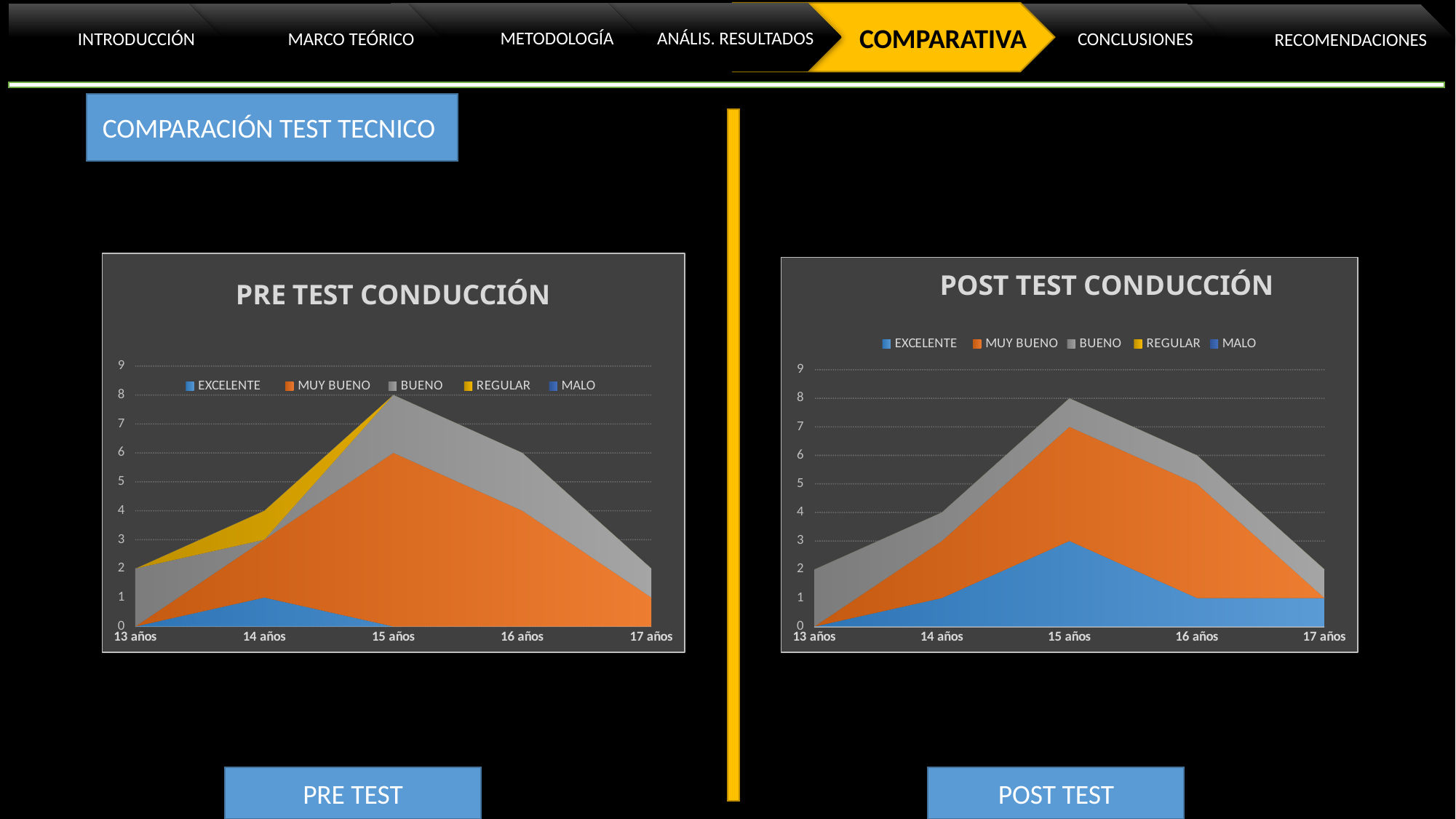
How many series does the legend of the PRE TEST CONDUCCIÓN chart list? 5 In the POST TEST CONDUCCIÓN chart, is the value for EXCELENTE at 15 años greater or less than 2? greater In the PRE TEST CONDUCCIÓN chart, at which age category does the plotted area reach its highest point? 15 años In the PRE TEST CONDUCCIÓN chart, do the plotted values rise or fall from 15 años to 17 años? fall What kind of chart is the PRE TEST CONDUCCIÓN chart? area chart Which series are listed in the legend of the POST TEST CONDUCCIÓN chart? EXCELENTE, MUY BUENO, BUENO, REGULAR, MALO What kind of chart is the POST TEST CONDUCCIÓN chart? area chart How many age categories are shown on the x axis of the PRE TEST CONDUCCIÓN chart? 5 In the POST TEST CONDUCCIÓN chart, is the value for EXCELENTE at 13 años greater or less than 1? less In the POST TEST CONDUCCIÓN chart, at which age category does the plotted area reach its highest point? 15 años How many series does the legend of the POST TEST CONDUCCIÓN chart list? 5 What is the title of the chart on the left side of the slide? PRE TEST CONDUCCIÓN